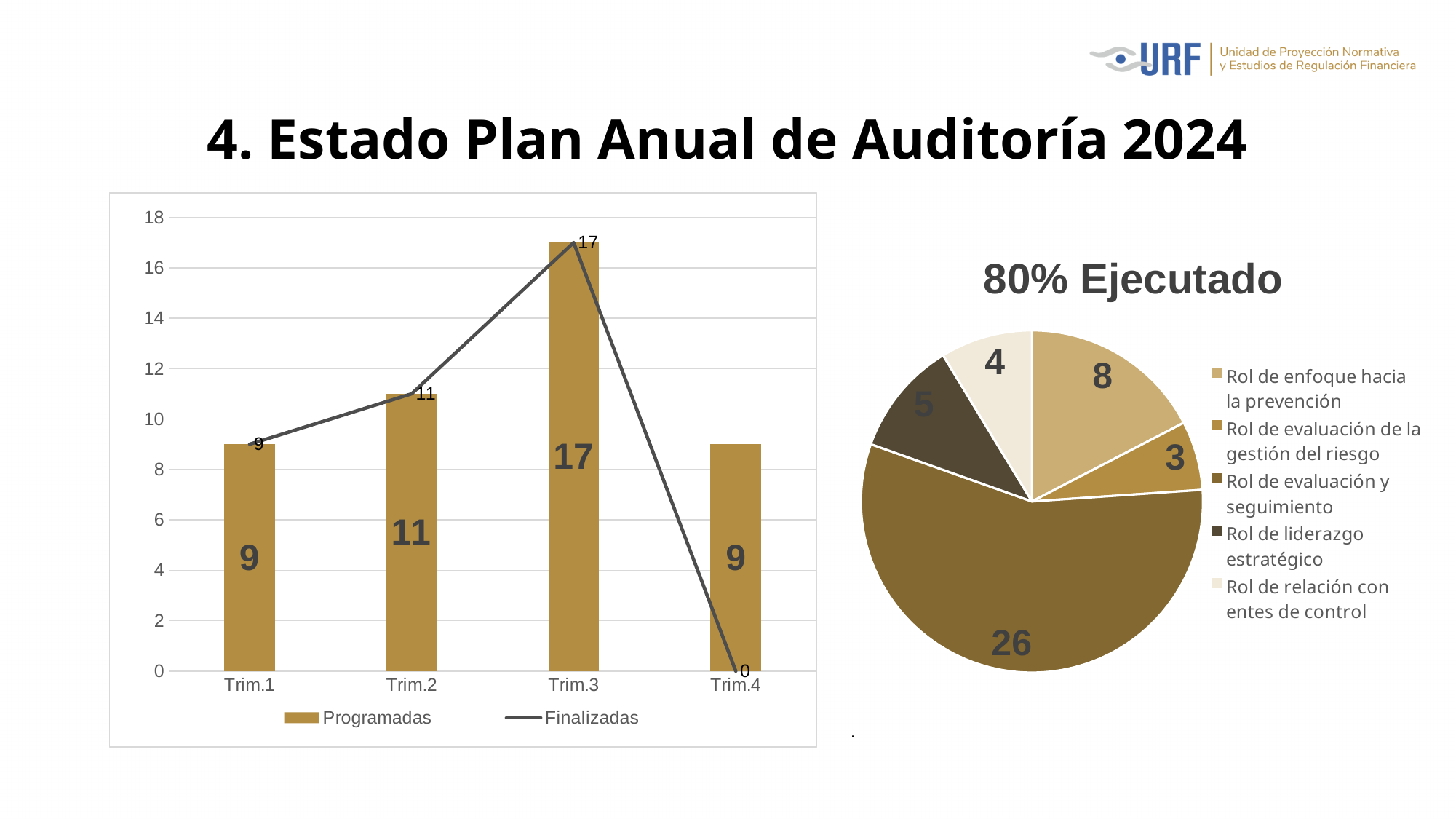
What type of chart is the chart on the right side of the slide? Pie chart In the left chart, what is the Finalizadas value for Trim.4? 0 In the left chart, what is the Programadas value for Trim.3? 17 In the left chart, how does the Finalizadas line change from Trim.3 to Trim.4? It falls In the left chart, which quarter has the highest Programadas value? Trim.3 In the left chart, what is the difference between the Programadas and Finalizadas values for Trim.4? 9 In the pie chart titled '80% Ejecutado', which category has the smallest slice? Rol de evaluación de la gestión del riesgo In the left chart, is the Programadas value for Trim.2 larger or smaller than the Programadas value for Trim.1? larger In the left chart, how many series does the legend list? 2 In the left chart, which quarter has the lowest Finalizadas value? Trim.4 In the pie chart titled '80% Ejecutado', what is the value for Rol de evaluación y seguimiento? 26 In the left chart, how many quarters are shown on the x axis? 4